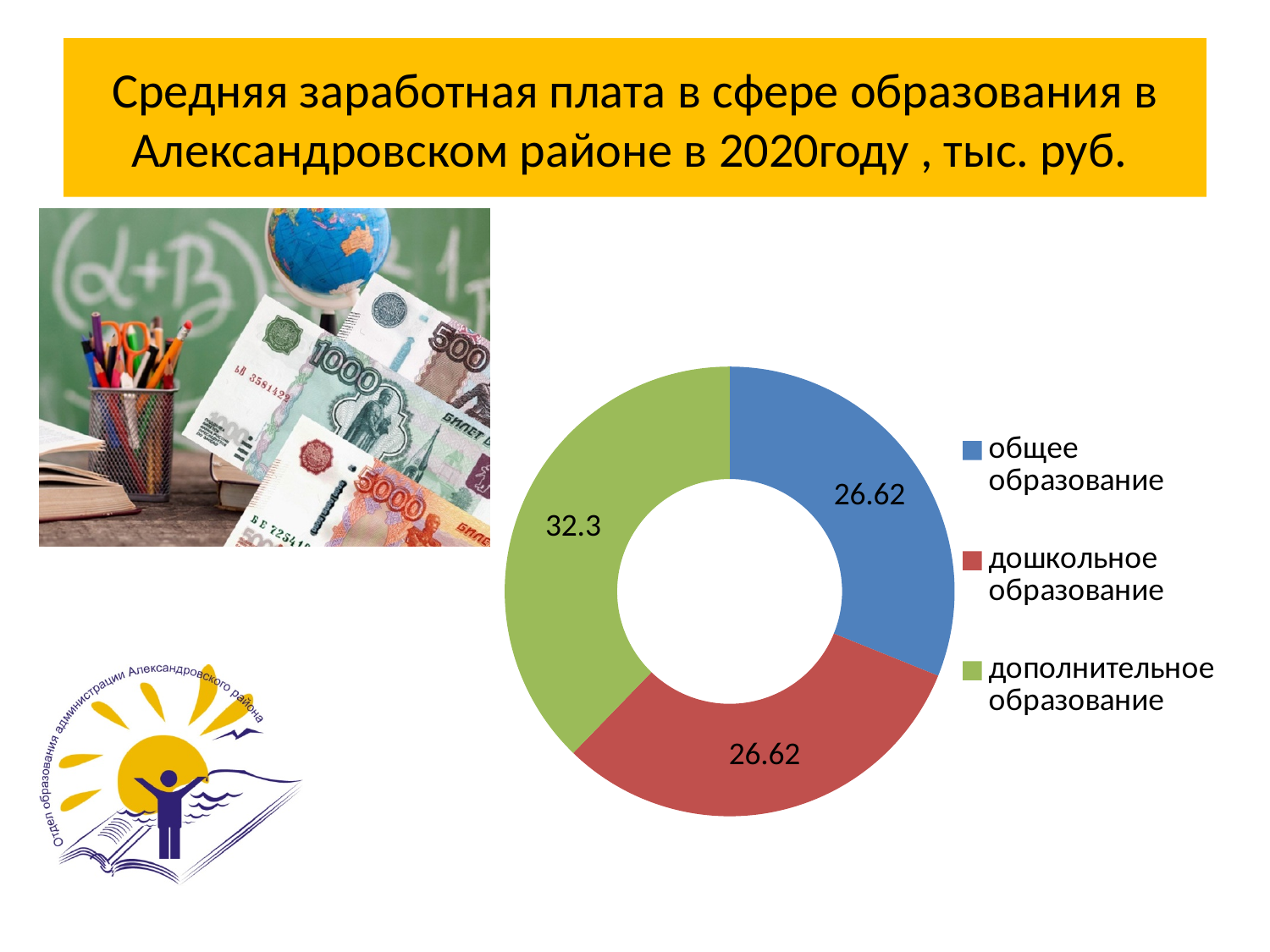
Which category has the highest value? дополнительное образование What is the value for дошкольное образование? 26.62 How many categories does the chart show? 3 What is the difference between the value for дополнительное образование and the value for дошкольное образование? 5.68 What is the sum of all three values shown on the chart? 85.54 What colour represents дополнительное образование in the chart? Green What type of chart is shown on the slide? Doughnut chart Which is larger, the value for дополнительное образование or the value for общее образование? дополнительное образование Are the values for общее образование and дошкольное образование equal or different? Equal What is the value for дополнительное образование? 32.3 How many entries does the legend list? 3 What is the value for общее образование? 26.62